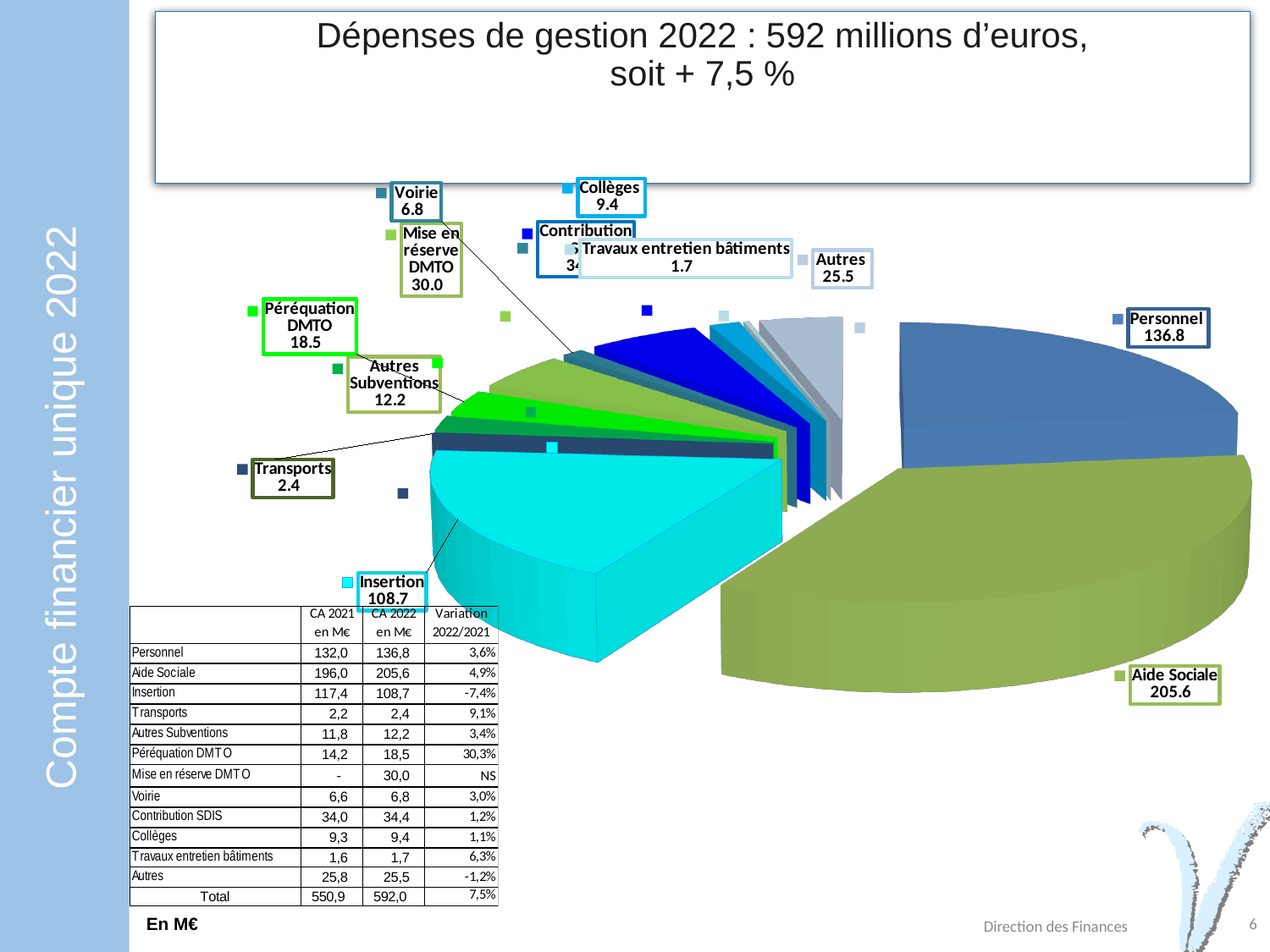
How many categories are shown in the pie chart? 12 What is the difference between the values for Aide Sociale and Personnel in the pie chart? 68.8 Which category has the largest slice in the pie chart? Aide Sociale What is the value for Insertion in the pie chart? 108.7 What is the value for Aide Sociale in the pie chart? 205.6 Which category has the smallest slice in the pie chart? Travaux entretien bâtiments What is the value for Mise en réserve DMTO in the pie chart? 30.0 What total amount of management expenditure for 2022 does the slide title state? 592 millions d'euros Which is larger in the pie chart, Personnel or Insertion? Personnel What is the value for Personnel in the pie chart? 136.8 What is the value for Péréquation DMTO in the pie chart? 18.5 What kind of chart is shown on the slide? pie chart